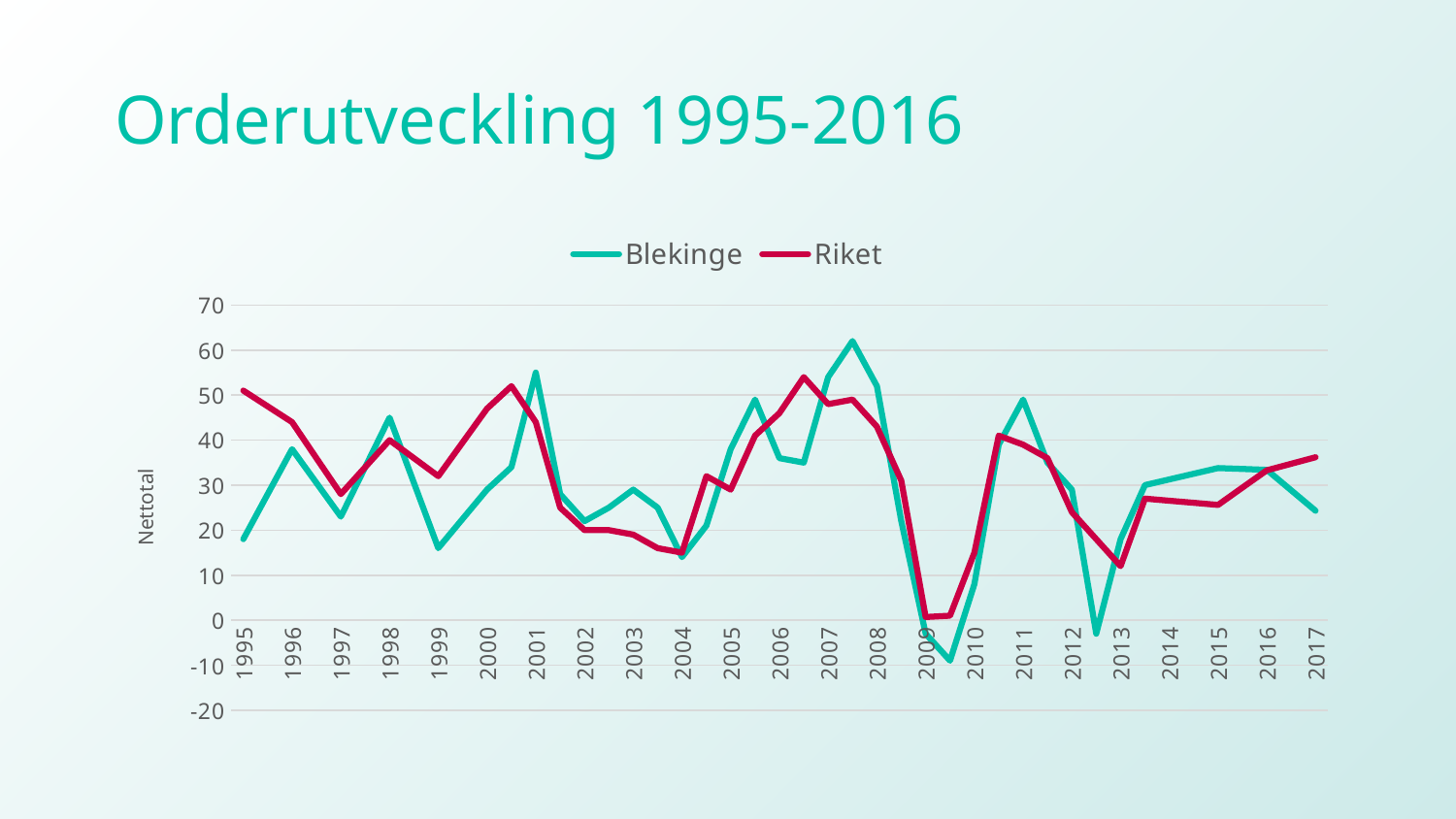
How many year labels are shown on the x axis? 23 Is the highest value of the Riket line greater or less than 50? greater How many series does the legend list? 2 Which series reaches the highest value anywhere on the chart? Blekinge Is the lowest value of the Blekinge line greater or less than 0? less What is the label on the vertical axis? Nettotal Does the Blekinge line rise or fall between 2016 and 2017? fall Which series reaches the lowest value anywhere on the chart? Blekinge At 2017, which series has the higher value, Blekinge or Riket? Riket What kind of chart is shown on the slide? line chart Is the lowest value of the Riket line greater or less than 10? less What is the title of the slide? Orderutveckling 1995-2016